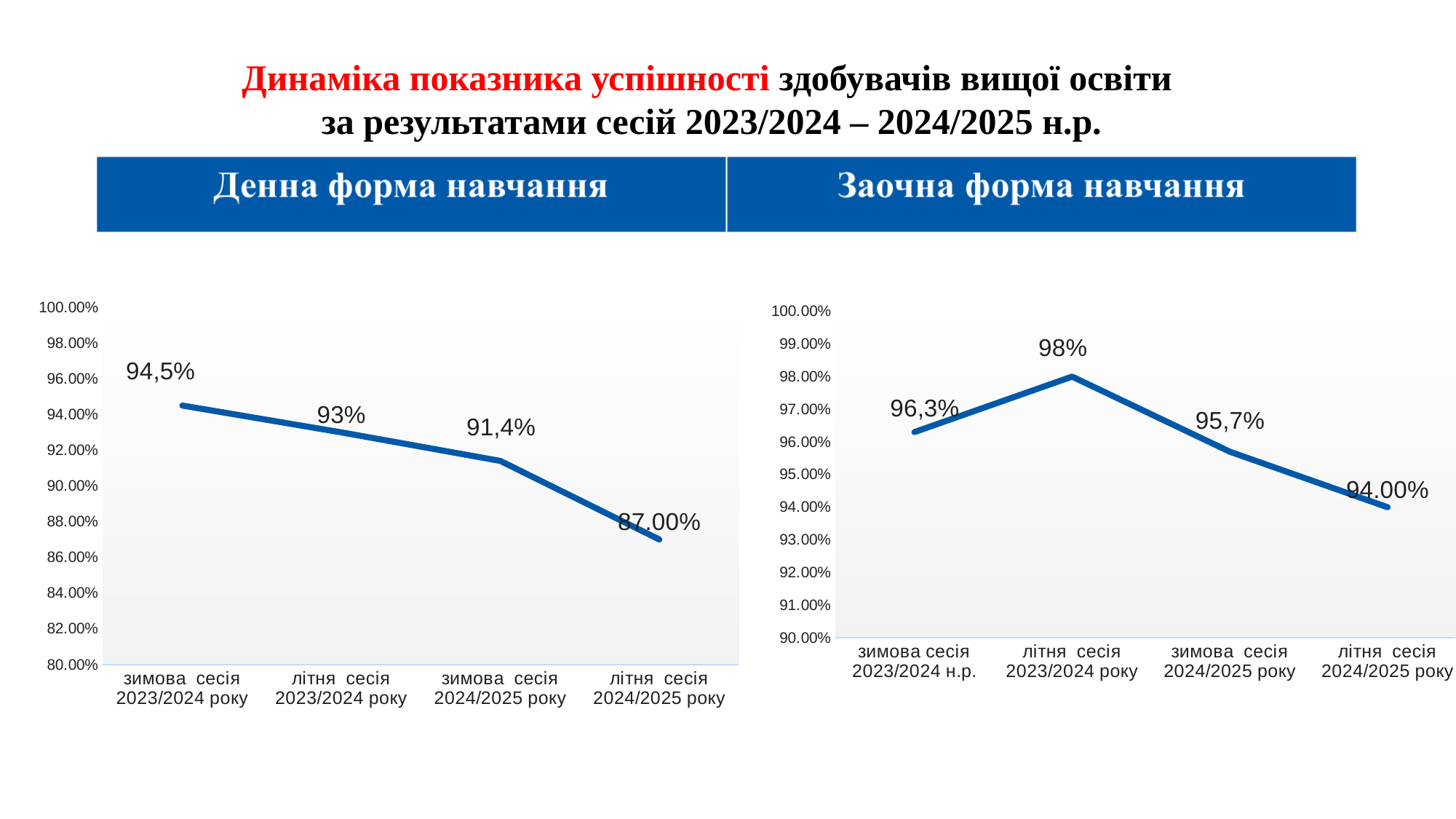
On the 'Заочна форма навчання' chart, what is the value for зимова сесія 2024/2025 року? 95,7% On the 'Заочна форма навчання' chart, what is the value for літня сесія 2023/2024 року? 98% What kind of chart is the 'Денна форма навчання' chart? line chart On the 'Денна форма навчання' chart, what is the difference between the values for зимова сесія 2023/2024 року and літня сесія 2024/2025 року? 7.5 percentage points On the 'Денна форма навчання' chart, do the values rise or fall from left to right along the x axis? fall On the 'Заочна форма навчання' chart, what is the difference between the values for літня сесія 2023/2024 року and літня сесія 2024/2025 року? 4 percentage points On the 'Денна форма навчання' chart, what is the value for літня сесія 2024/2025 року? 87.00% On the 'Денна форма навчання' chart, what is the value for зимова сесія 2023/2024 року? 94,5% On the 'Заочна форма навчання' chart, which session has the highest value? літня сесія 2023/2024 року Which is larger: the value for зимова сесія 2023/2024 on the 'Денна форма навчання' chart or on the 'Заочна форма навчання' chart? Заочна форма навчання On the 'Денна форма навчання' chart, which session has the lowest value? літня сесія 2024/2025 року How many data points are plotted on the 'Заочна форма навчання' chart? 4